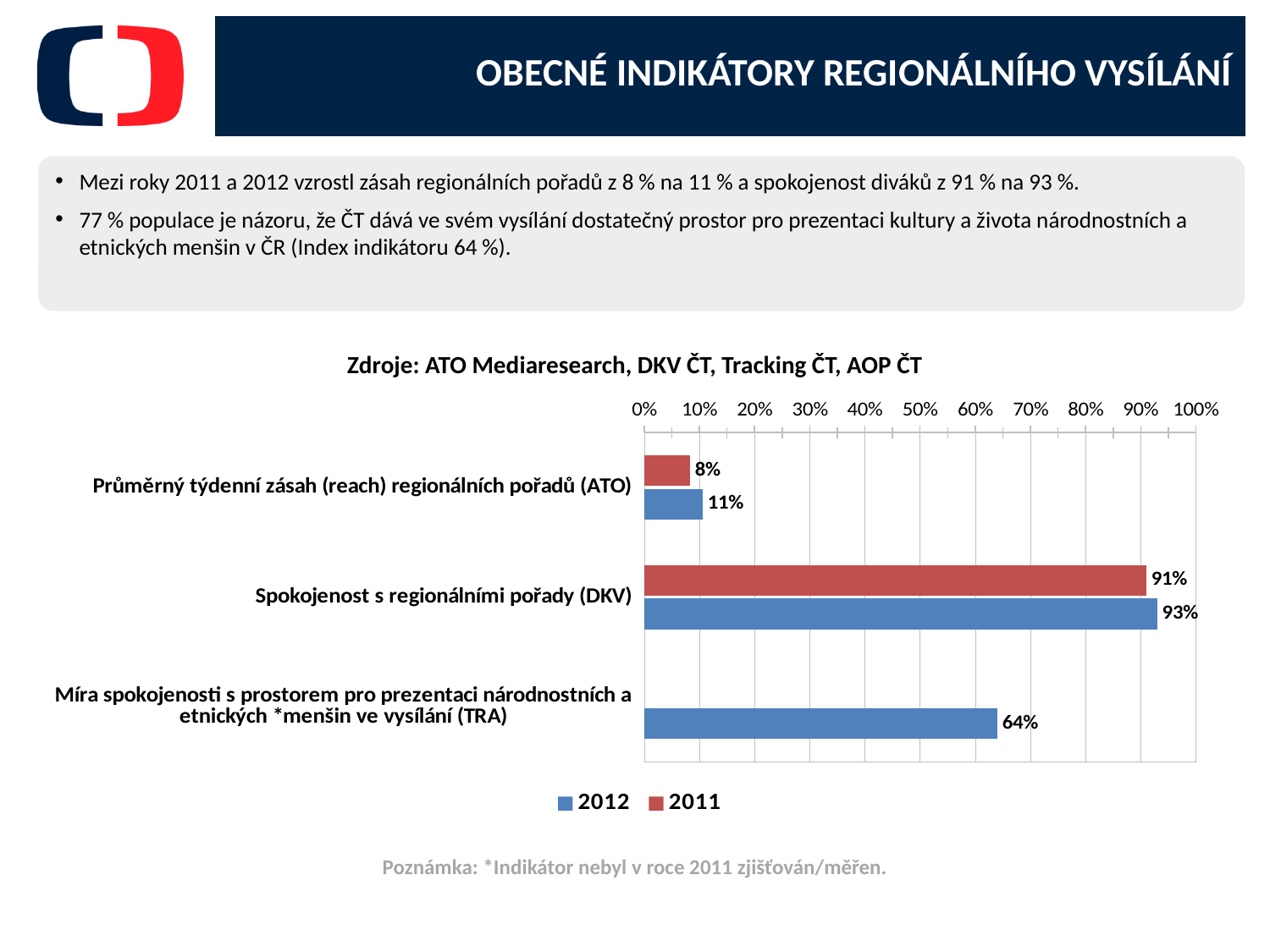
Which category has the highest 2012 value? Spokojenost s regionálními pořady (DKV) How many categories are shown on the chart? 3 Which category has the lowest 2012 value? Průměrný týdenní zásah (reach) regionálních pořadů (ATO) What is the 2012 value for Průměrný týdenní zásah (reach) regionálních pořadů (ATO)? 11% What is the difference between the 2012 and 2011 values for Spokojenost s regionálními pořady (DKV)? 2 percentage points What kind of chart is shown on the slide? Bar chart How many series does the legend list? 2 By how many percentage points did Průměrný týdenní zásah (reach) regionálních pořadů (ATO) change from 2011 to 2012? 3 percentage points For Spokojenost s regionálními pořady (DKV), which year has the larger value, 2011 or 2012? 2012 What is the 2012 value for Míra spokojenosti s prostorem pro prezentaci národnostních a etnických menšin ve vysílání (TRA)? 64% Which colour represents the 2011 series in the chart? Red What is the 2011 value for Spokojenost s regionálními pořady (DKV)? 91%